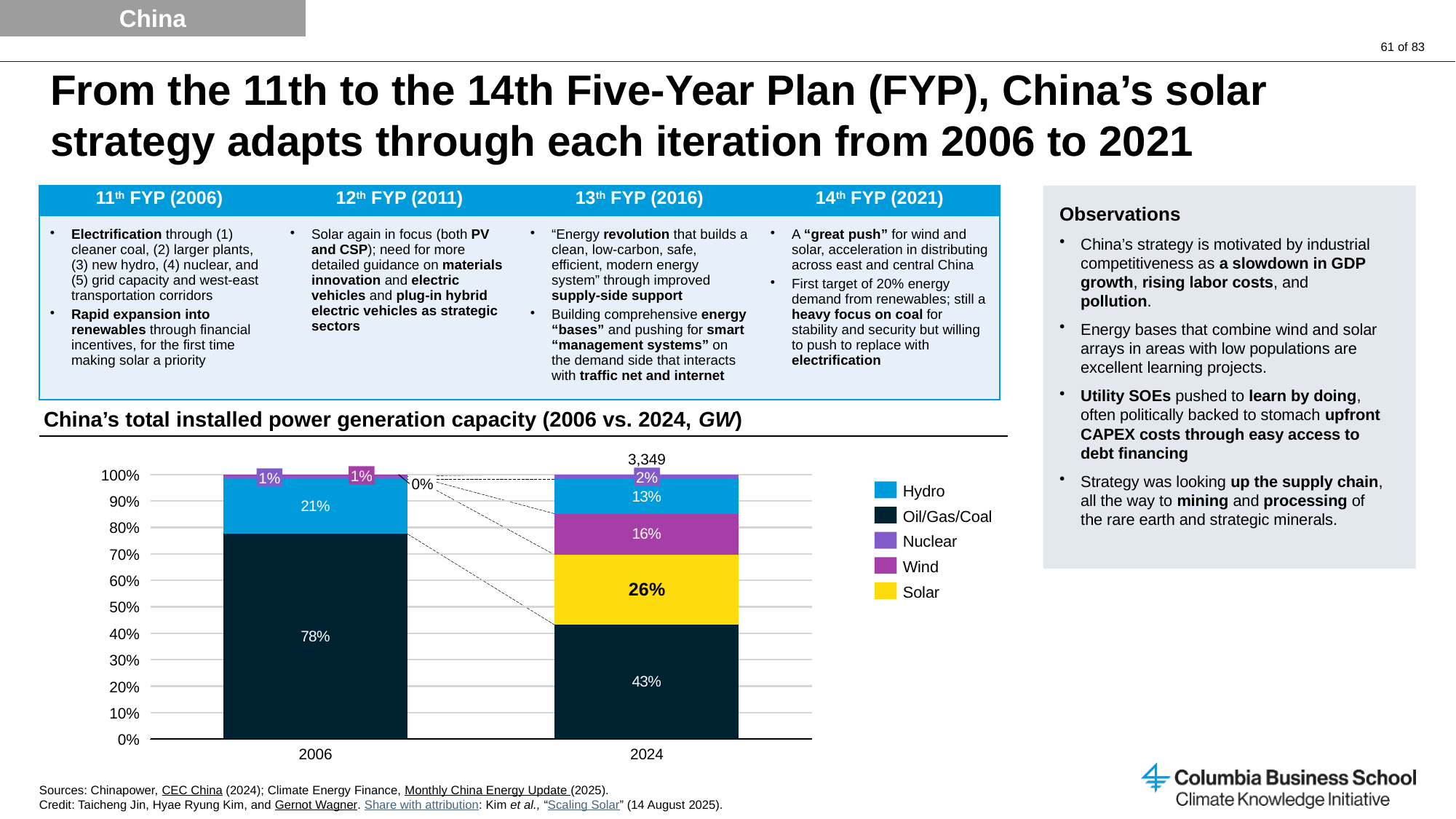
How many series does the legend of the capacity chart list? 5 What share of China's installed capacity was Hydro in 2006? 21% What kind of chart is shown under 'China's total installed power generation capacity'? Stacked bar chart By how many percentage points did the Oil/Gas/Coal share fall from 2006 to 2024? 35 percentage points Which is larger in 2024: the Hydro share or the Wind share? Wind What share of China's installed capacity was Wind in 2024? 16% What share of China's installed capacity was Solar in 2006? 0% What total installed capacity value (GW) is printed above the 2024 bar? 3,349 What share of China's installed capacity was Oil/Gas/Coal in 2006? 78% How many years (categories) are shown on the x axis of the capacity chart? 2 Which source had the largest share of installed capacity in 2024? Oil/Gas/Coal What share of China's installed capacity was Solar in 2024? 26%